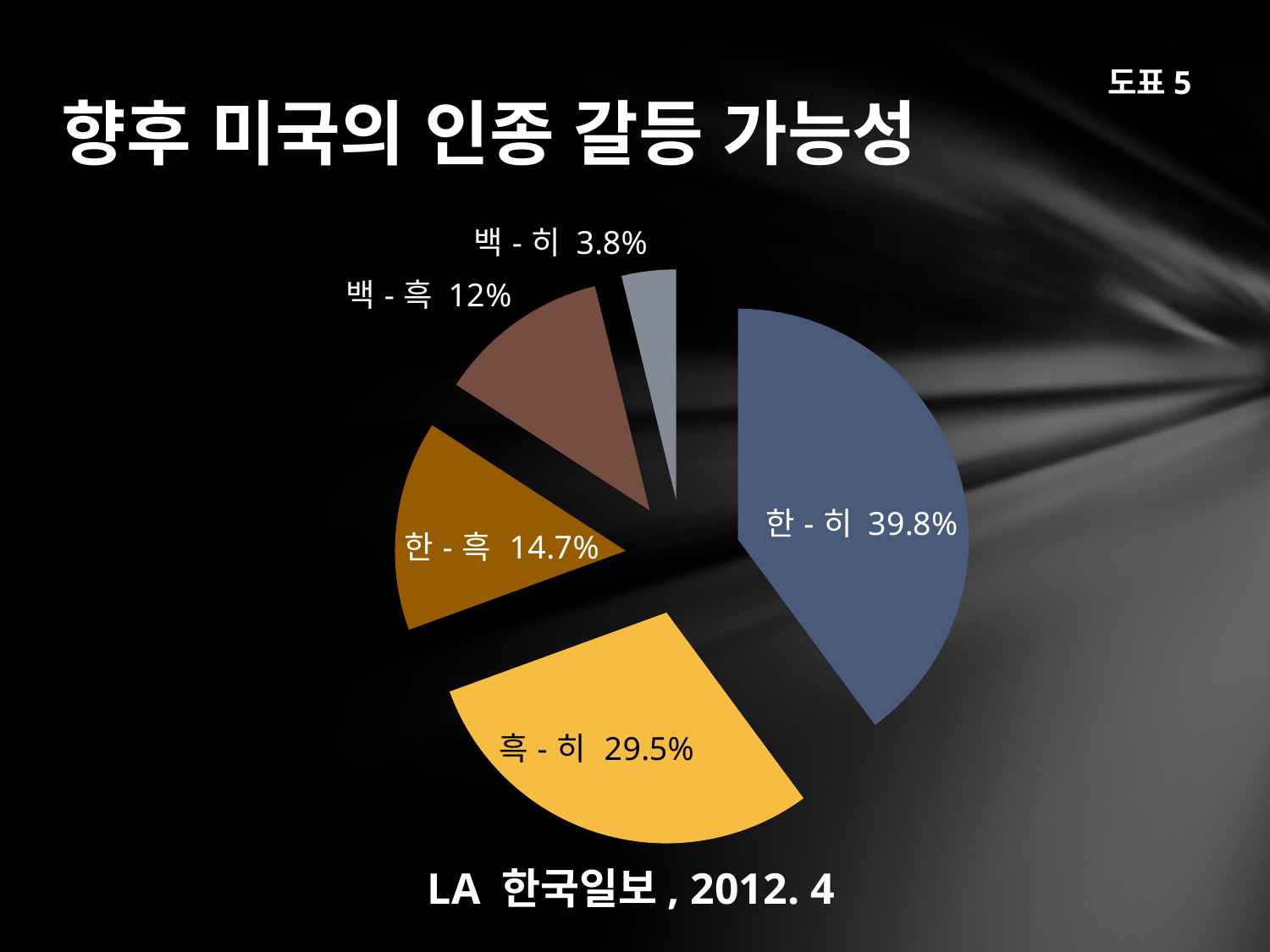
What share of the pie does 한 - 히 have? 39.8% Which slice of the pie is the largest? 한 - 히 Which slice of the pie is the smallest? 백 - 히 What share of the pie does 흑 - 히 have? 29.5% How many slices does the pie chart have? 5 What is the title of the chart on the slide? 향후 미국의 인종 갈등 가능성 What share of the pie does 백 - 히 have? 3.8% What share of the pie does 한 - 흑 have? 14.7% What kind of chart is shown on the slide? pie chart What is the difference in percentage points between 한 - 히 and 흑 - 히? 10.3 What share of the pie does 백 - 흑 have? 12% Which is larger, 한 - 흑 or 백 - 흑? 한 - 흑